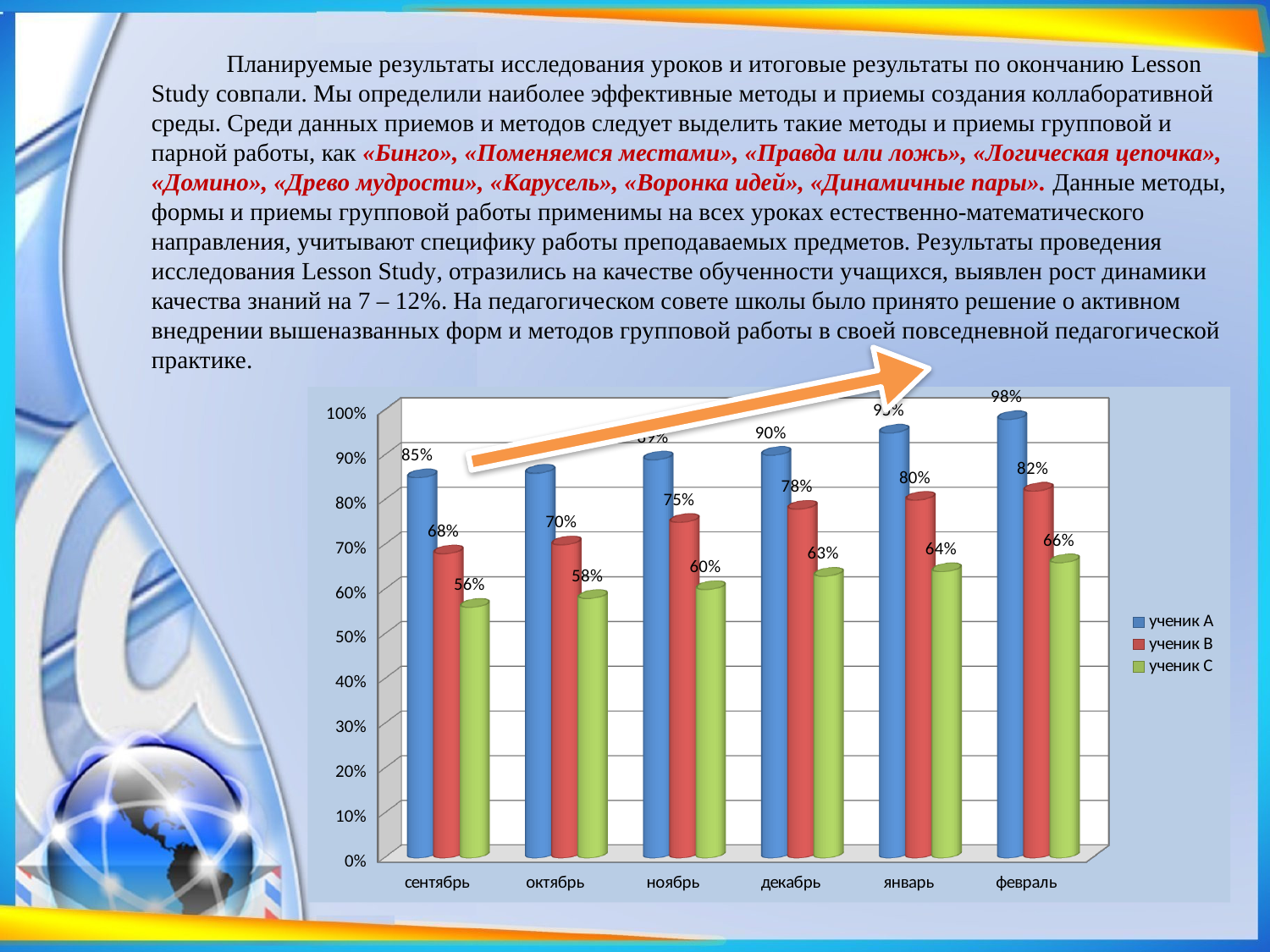
In which month is the value for ученик A the highest? февраль What kind of chart is shown on the slide? bar chart What is the value for ученик C in декабрь? 63% What is the difference between the value for ученик B in февраль and in сентябрь? 14% How many series does the legend list? 3 What is the value for ученик B in февраль? 82% In ноябрь, which is larger: the value for ученик B or for ученик C? ученик B What is the value for ученик A in сентябрь? 85% Do the values for ученик C rise or fall from сентябрь to февраль? rise In which month is the value for ученик C the lowest? сентябрь How many months are shown on the x axis? 6 Is the value for ученик A in октябрь greater or less than 80%? greater